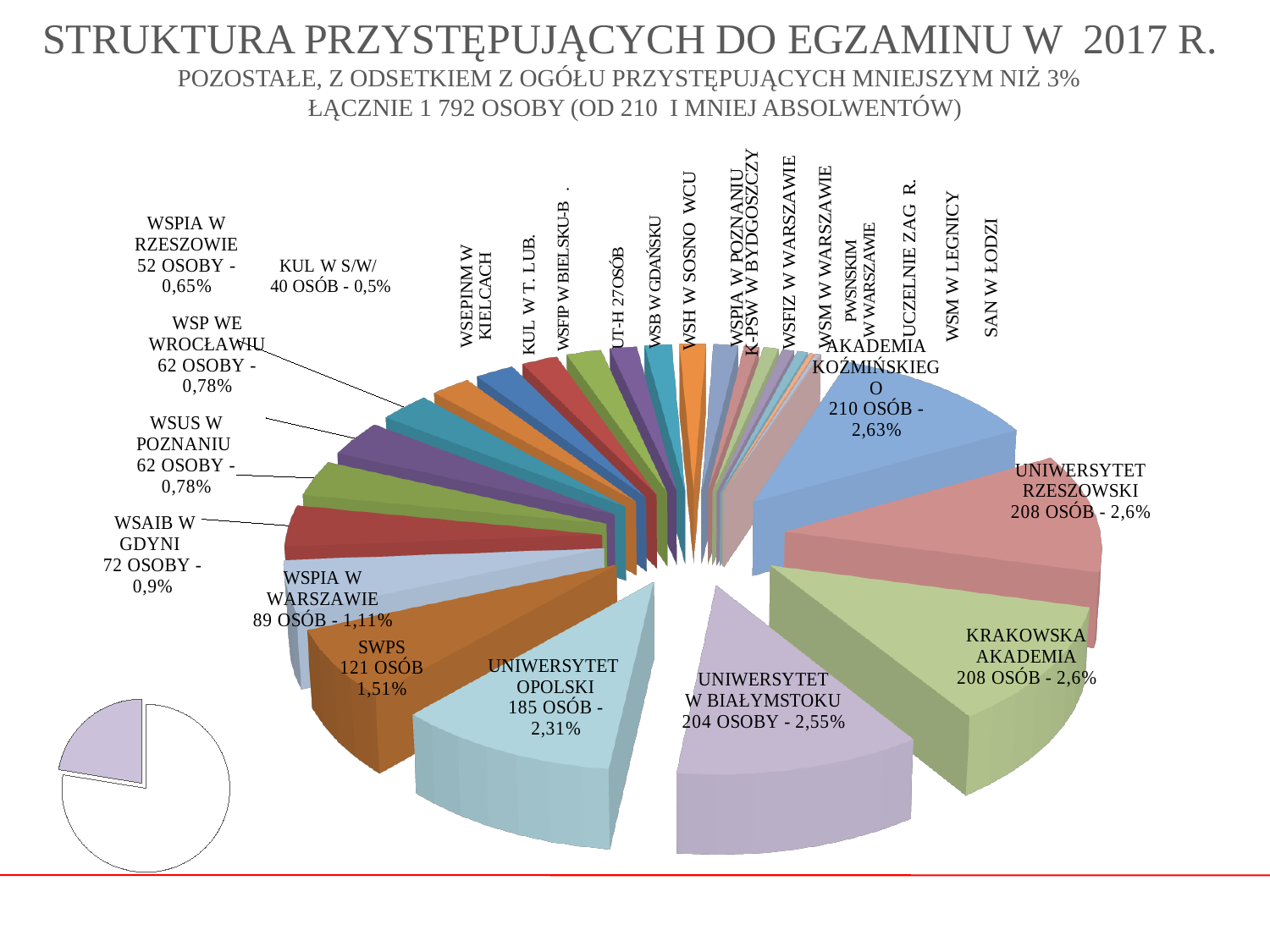
What is the difference in number of people between Uniwersytet Opolski and SWPS? 64 What percentage is shown for SWPS? 1,51% How many people does the slice for Akademia Koźmińskiego represent? 210 osób What is the title of the chart on the slide? STRUKTURA PRZYSTĘPUJĄCYCH DO EGZAMINU W 2017 R. What percentage share is shown for Uniwersytet w Białymstoku? 2,55% Which has more people, SWPS or WSPiA w Warszawie? SWPS How many people are shown for WSPiA w Warszawie? 89 osób What kind of chart is shown on the slide? pie chart What is the difference in number of people between Akademia Koźmińskiego and Uniwersytet w Białymstoku? 6 Which institution has the largest slice in the pie chart? Akademia Koźmińskiego How many people are shown for Uniwersytet Opolski? 185 osób What percentage share is shown for WSAiB w Gdyni? 0,9%